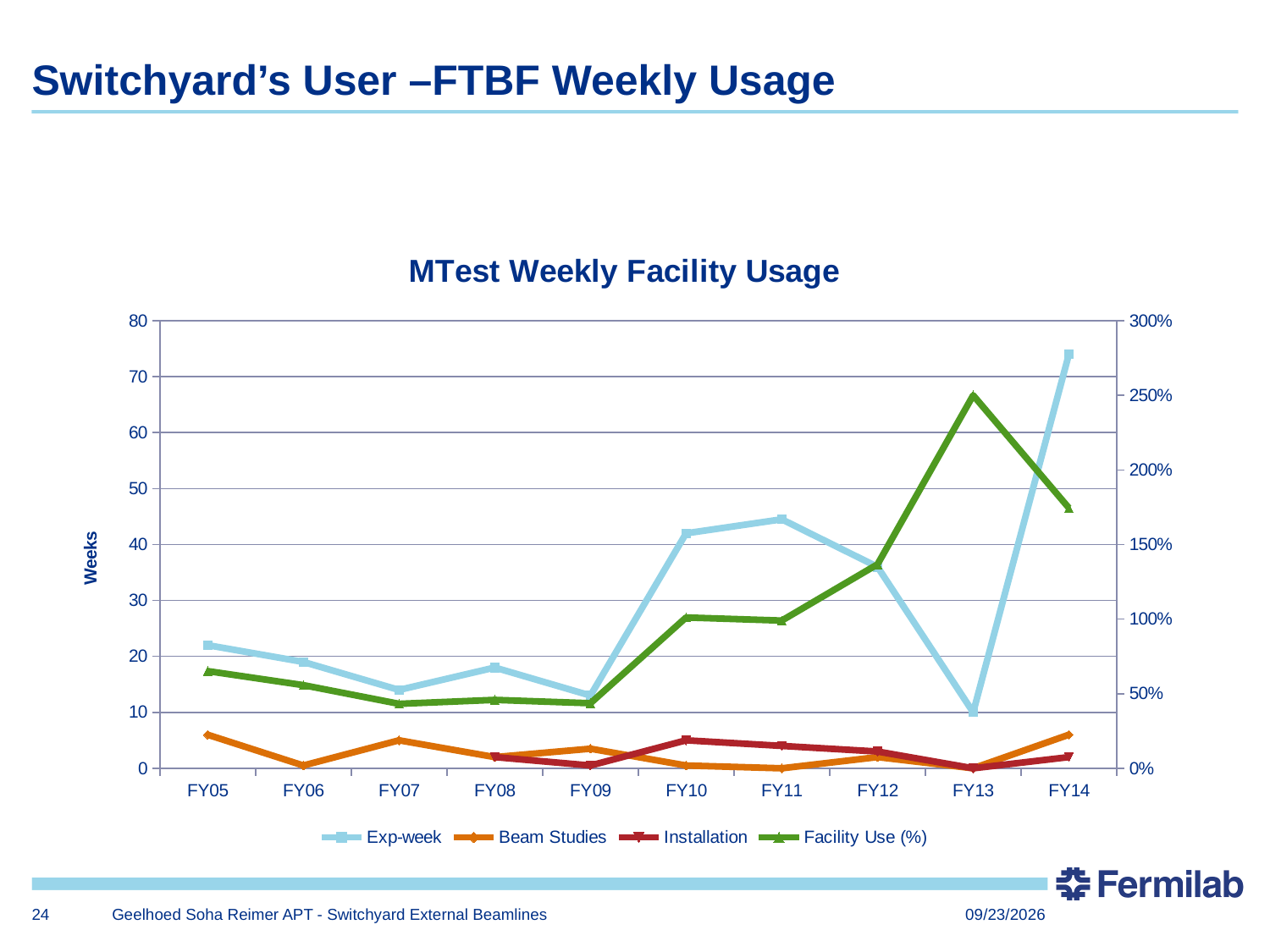
How many series does the legend list? 4 Is the Facility Use (%) value for FY13 greater or less than 200%? greater Is the Exp-week value for FY13 greater or less than 20? less In which fiscal year is Facility Use (%) highest? FY13 Is the Exp-week value for FY14 greater or less than 70? greater What is the title of the chart? MTest Weekly Facility Usage What kind of chart is shown on the slide? line chart In which fiscal year is the Exp-week value lowest? FY13 Does the Exp-week series rise or fall from FY05 to FY07? fall In which fiscal year is the Exp-week value highest? FY14 How many fiscal years are shown on the x axis? 10 Which is larger, the Exp-week value for FY11 or for FY12? FY11